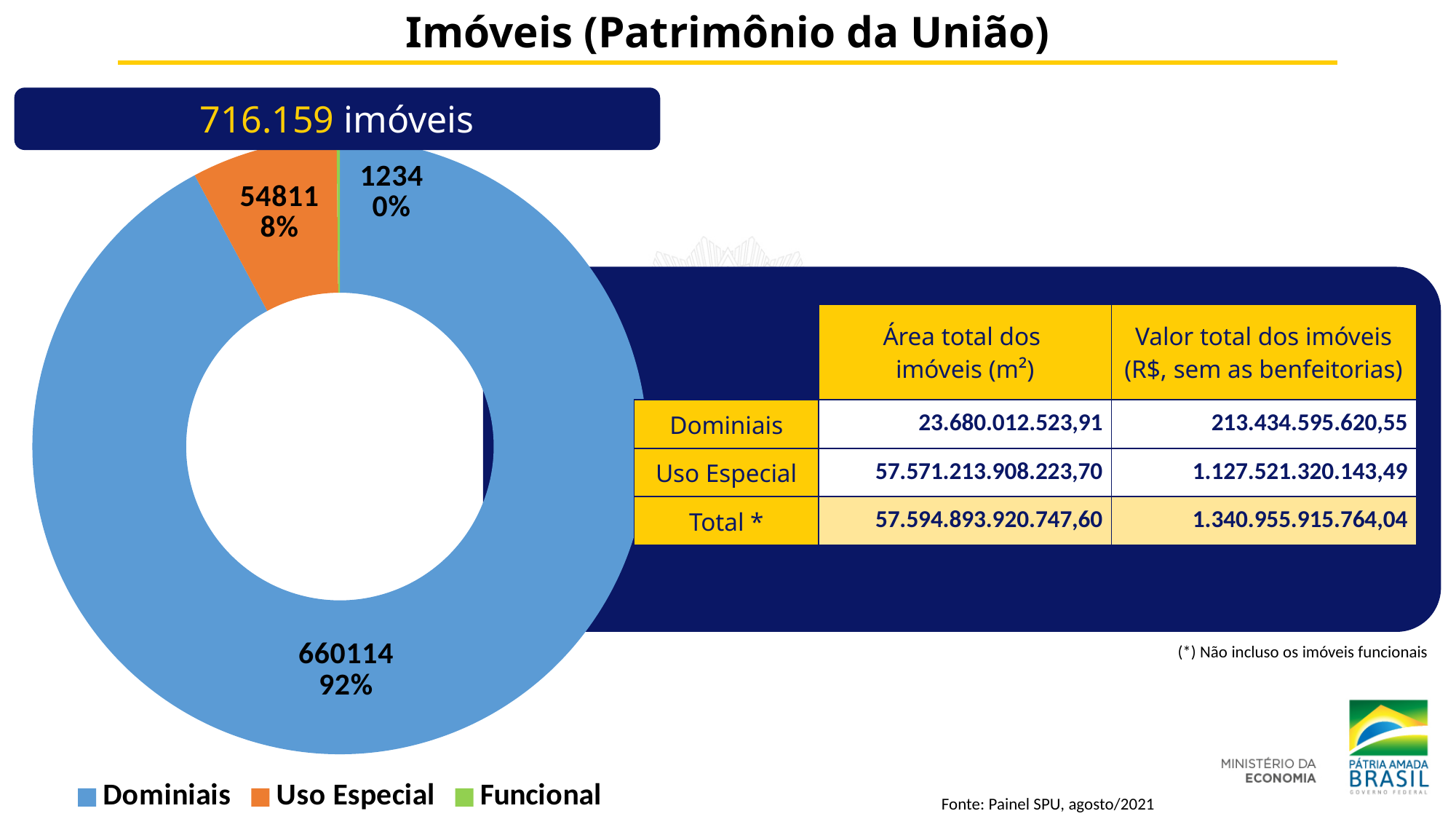
What percentage share of the doughnut chart does Dominiais represent? 92% What is the value shown for Uso Especial in the doughnut chart? 54811 What is the difference between the values for Dominiais and Uso Especial in the doughnut chart? 605303 How many categories does the doughnut chart show? 3 What kind of chart is shown on the slide? Doughnut (pie) chart What percentage share of the doughnut chart does Uso Especial represent? 8% Which colour represents Uso Especial in the doughnut chart? Orange What is the value shown for Dominiais in the doughnut chart? 660114 Which category has the smallest slice in the doughnut chart? Funcional Which category has the largest slice in the doughnut chart? Dominiais How many entries does the chart legend list? 3 What is the value shown for Funcional in the doughnut chart? 1234